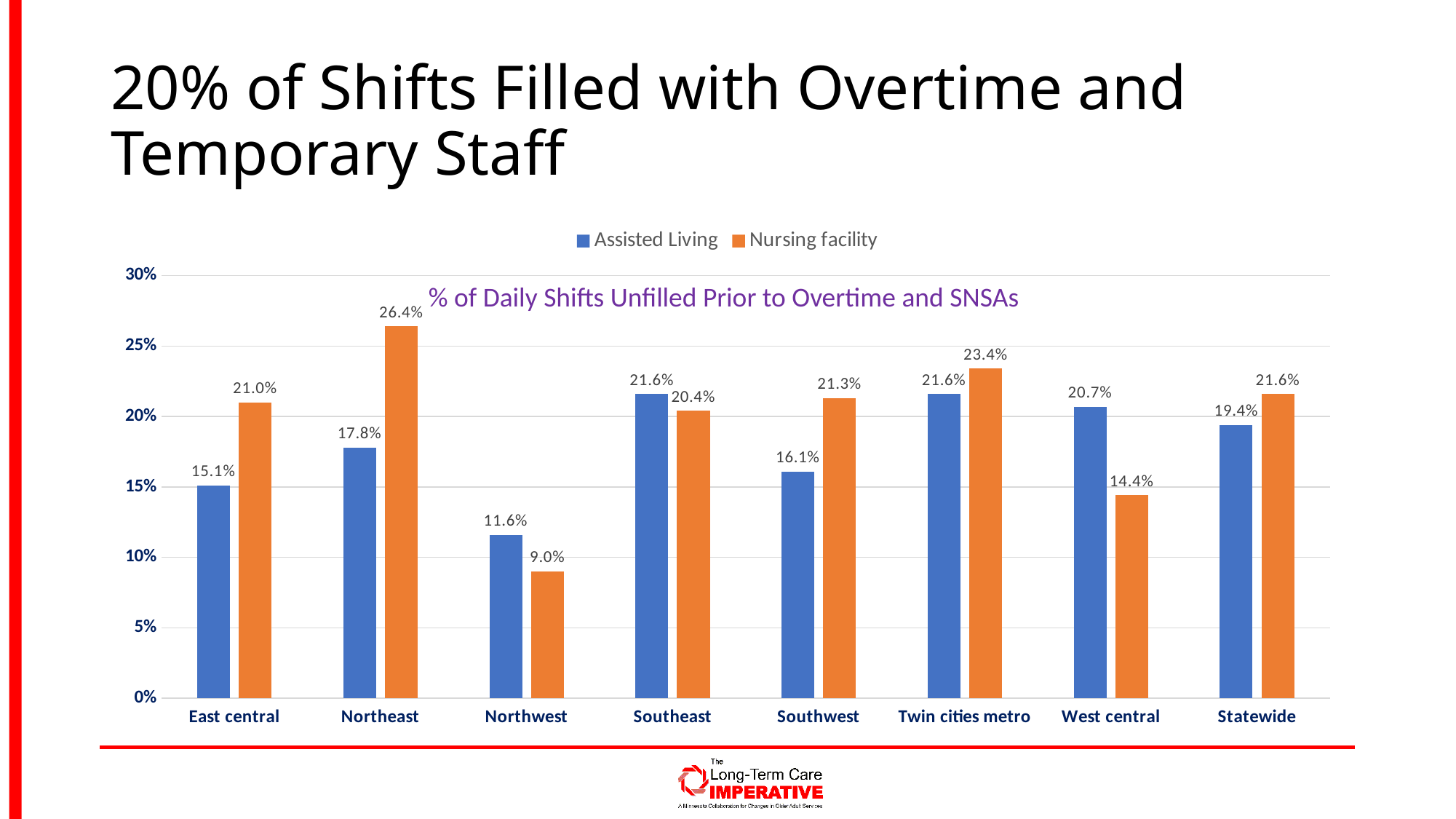
What is the Nursing facility value for Statewide? 21.6% What kind of chart is shown on the slide? Bar chart What is the Nursing facility value for West central? 14.4% How many series does the legend list? 2 Which region has the lowest Assisted Living value? Northwest What is the Assisted Living value for Northeast? 17.8% What is the difference between the Nursing facility and Assisted Living values for East central? 5.9% Which is larger for Southeast: the Assisted Living value or the Nursing facility value? Assisted Living How many regions (categories) are shown on the x axis? 8 What is the title printed inside the chart area? % of Daily Shifts Unfilled Prior to Overtime and SNSAs Which colour represents the Nursing facility series? Orange Which region has the highest Nursing facility value? Northeast